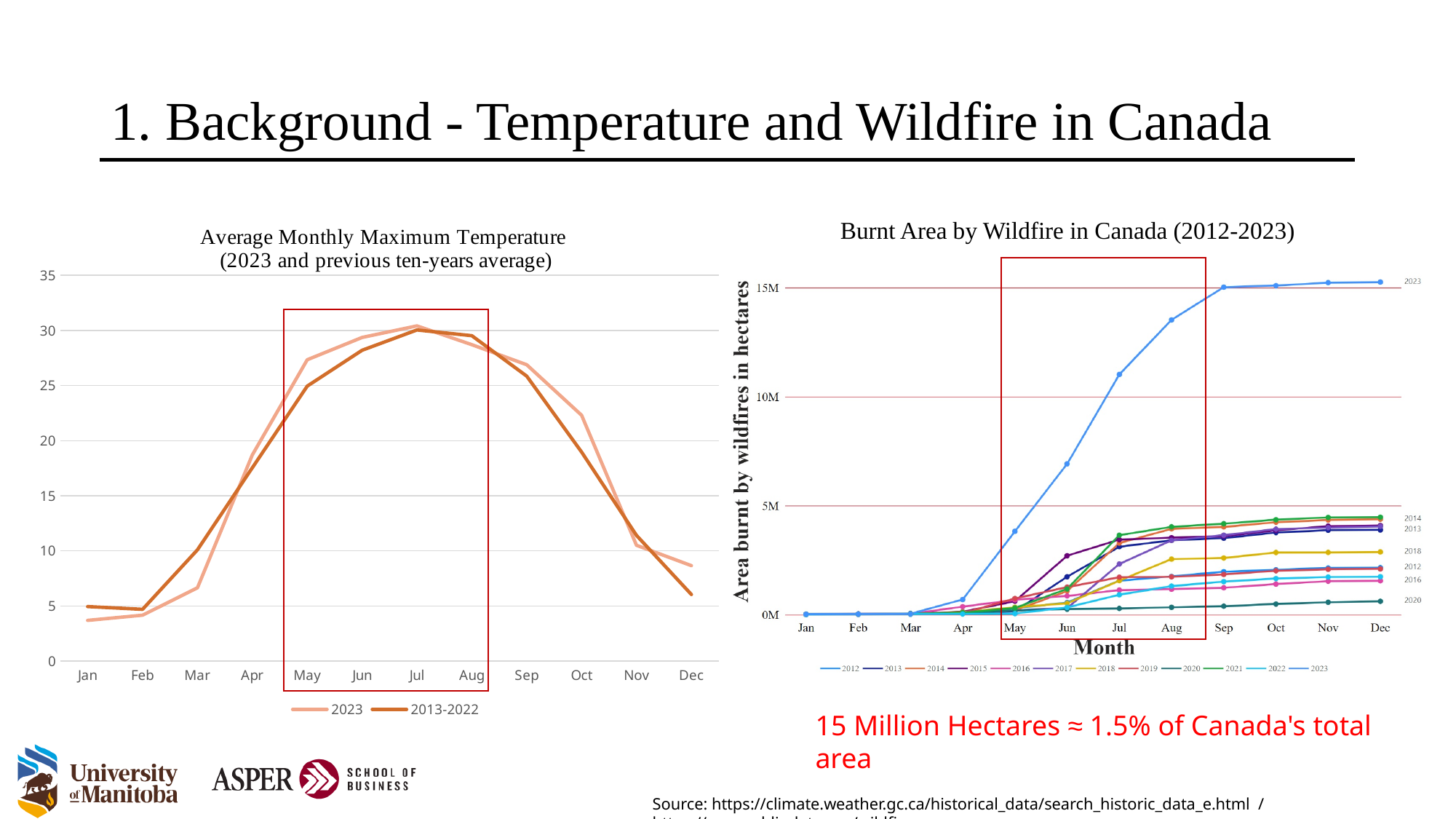
How many series does the legend of the 'Average Monthly Maximum Temperature' chart list? 2 What kind of chart is the 'Average Monthly Maximum Temperature' chart on the left? line chart In the 'Burnt Area by Wildfire in Canada (2012-2023)' chart, is the 2023 value for Jul greater or less than 10M? greater How many months are shown on the x axis of the 'Burnt Area by Wildfire in Canada (2012-2023)' chart? 12 In the 'Average Monthly Maximum Temperature' chart, is the 2023 value for May greater or less than 25? greater How many series does the legend of the 'Burnt Area by Wildfire in Canada (2012-2023)' chart list? 12 In the 'Burnt Area by Wildfire in Canada (2012-2023)' chart, which year has the highest burnt area in Dec? 2023 In the 'Average Monthly Maximum Temperature' chart, does the 2023 line rise or fall from Jan to Jul? rise In the 'Average Monthly Maximum Temperature' chart, is the 2013-2022 value for Apr greater or less than 20? less In the 'Average Monthly Maximum Temperature' chart, which series has the higher value in Mar, 2023 or 2013-2022? 2013-2022 In the 'Burnt Area by Wildfire in Canada (2012-2023)' chart, which year has the lowest burnt area in Dec? 2020